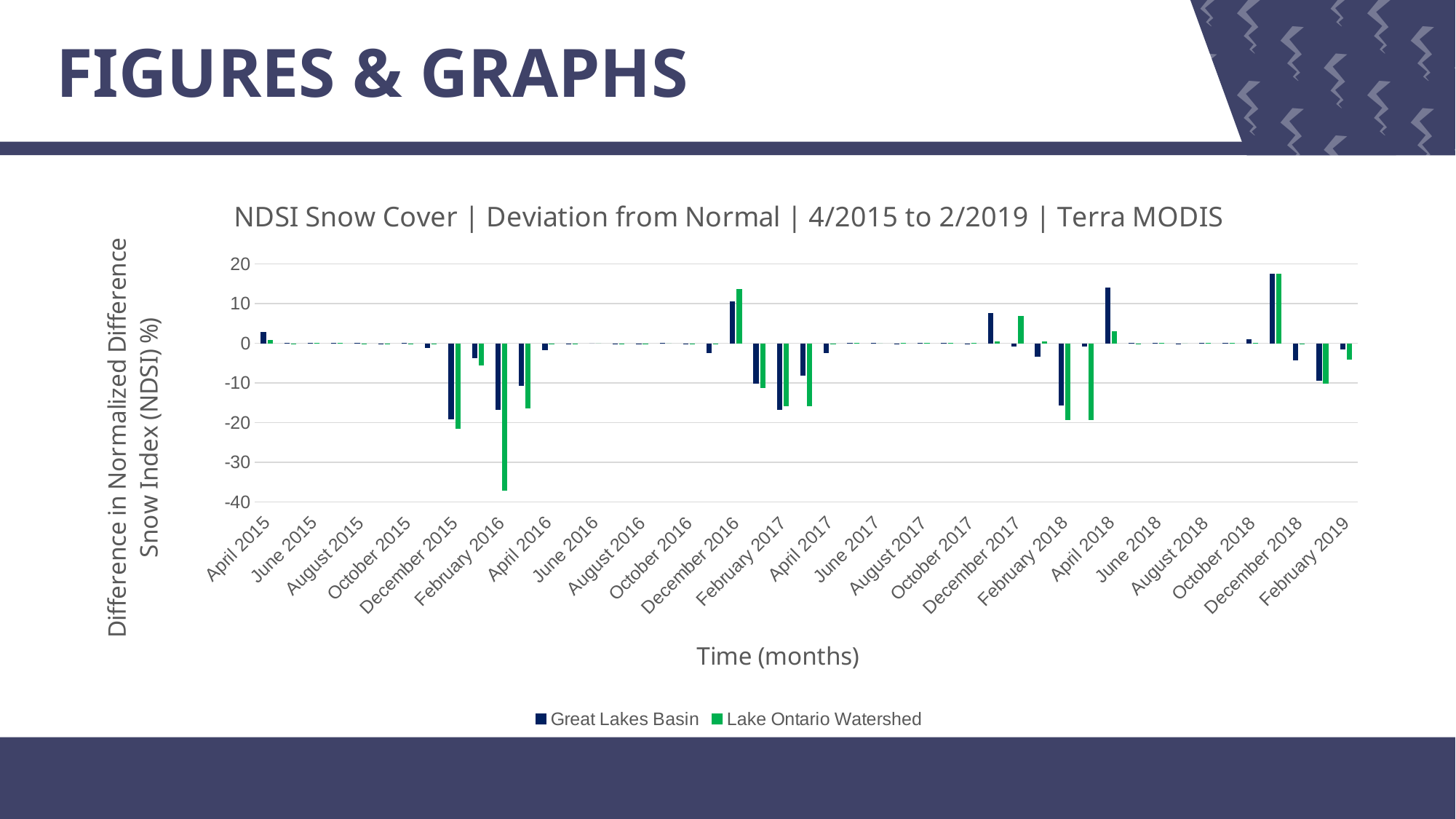
What kind of chart is shown on the slide? bar chart Is the Lake Ontario Watershed value for December 2016 greater or less than 10? greater Is the Great Lakes Basin value for April 2018 greater or less than 10? greater Is the Lake Ontario Watershed value for February 2016 greater or less than -30? less What is the title of the chart? NDSI Snow Cover | Deviation from Normal | 4/2015 to 2/2019 | Terra MODIS In which month does the Lake Ontario Watershed series reach its highest value? November 2018 In February 2016, which series has the lower value, Great Lakes Basin or Lake Ontario Watershed? Lake Ontario Watershed In which month does the Lake Ontario Watershed series reach its lowest value? February 2016 How many series does the legend list? 2 What is the label of the x axis? Time (months) In April 2018, which series has the higher value, Great Lakes Basin or Lake Ontario Watershed? Great Lakes Basin